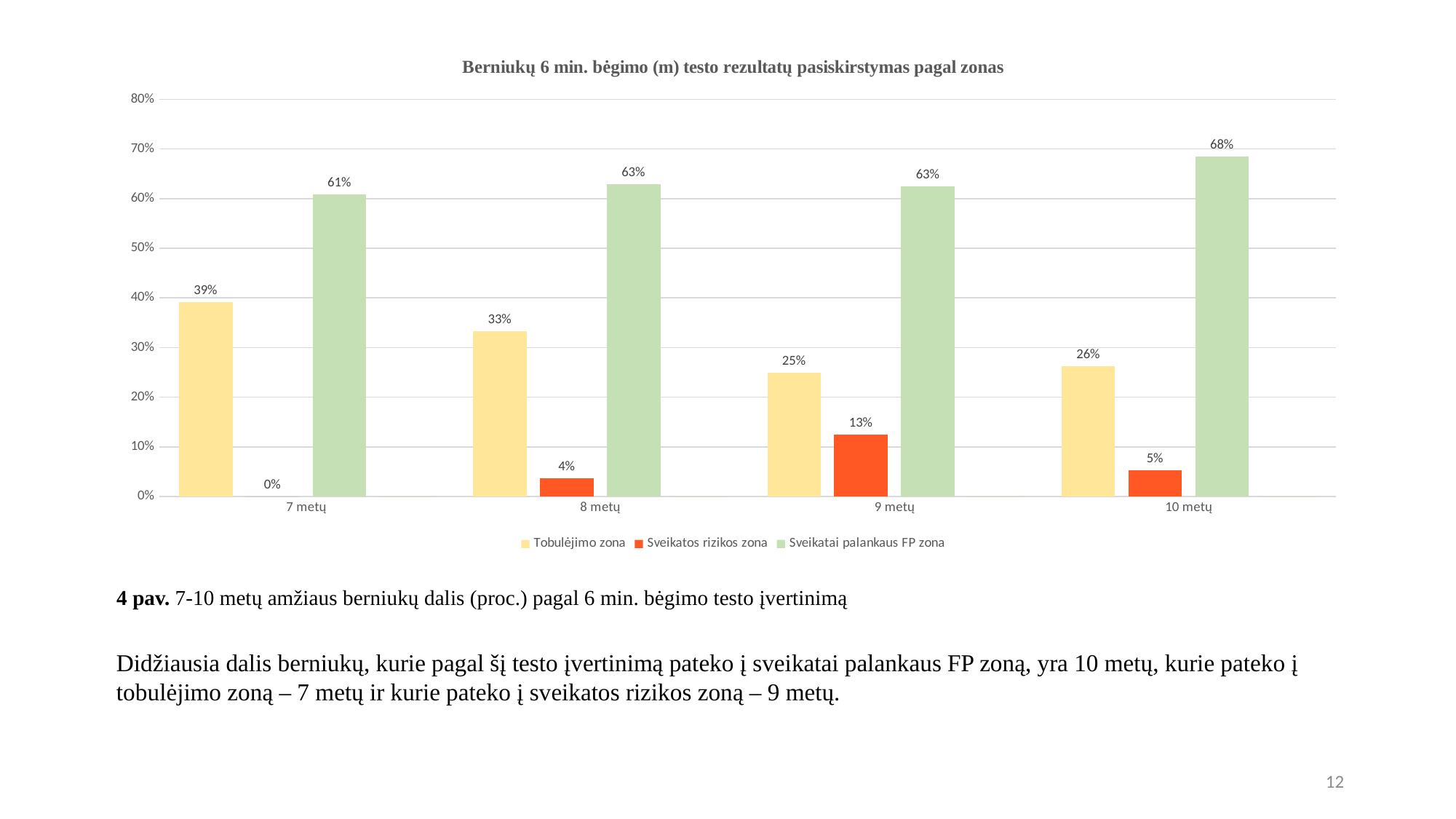
Which age group has the lowest value for Tobulėjimo zona? 9 metų How many age groups are shown on the x axis? 4 What is the value for Sveikatai palankaus FP zona for 10 metų? 68% Is the value for Sveikatos rizikos zona for 9 metų greater or less than 10%? greater What is the difference between the Sveikatai palankaus FP zona value for 10 metų and for 7 metų? 7% What is the value for Sveikatos rizikos zona for 7 metų? 0% Which age group has the highest value for Sveikatai palankaus FP zona? 10 metų Which is larger: the Tobulėjimo zona value for 8 metų or for 10 metų? 8 metų What is the value for Sveikatos rizikos zona for 9 metų? 13% How many series does the legend list? 3 What kind of chart is shown on the slide? Bar chart What is the value for Tobulėjimo zona for 7 metų? 39%